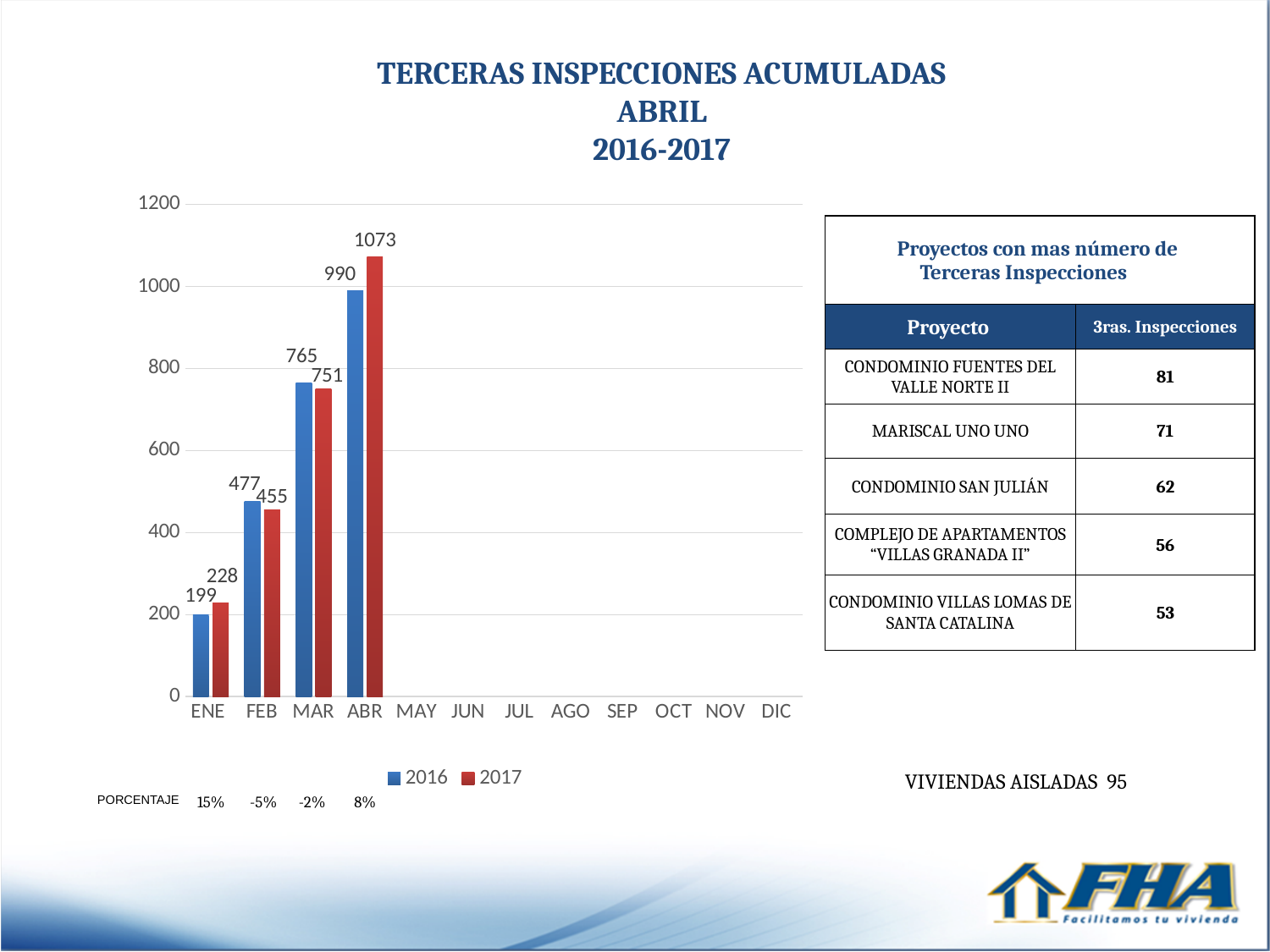
What is the value for 2017 in ENE? 228 How many series does the legend list? 2 What is the value for 2016 in FEB? 477 What is the value for 2017 in ABR? 1073 What is the difference between the 2016 and 2017 values in MAR? 14 Do the 2016 values rise or fall from ENE to ABR? Rise How many months are shown on the x axis? 12 Which month has the highest value for the 2016 series? ABR What is the difference between the 2017 and 2016 values in ABR? 83 In FEB, which series has the larger value, 2016 or 2017? 2016 Which month has the lowest value for the 2017 series among the months with data? ENE What kind of chart is shown on the slide? Bar chart